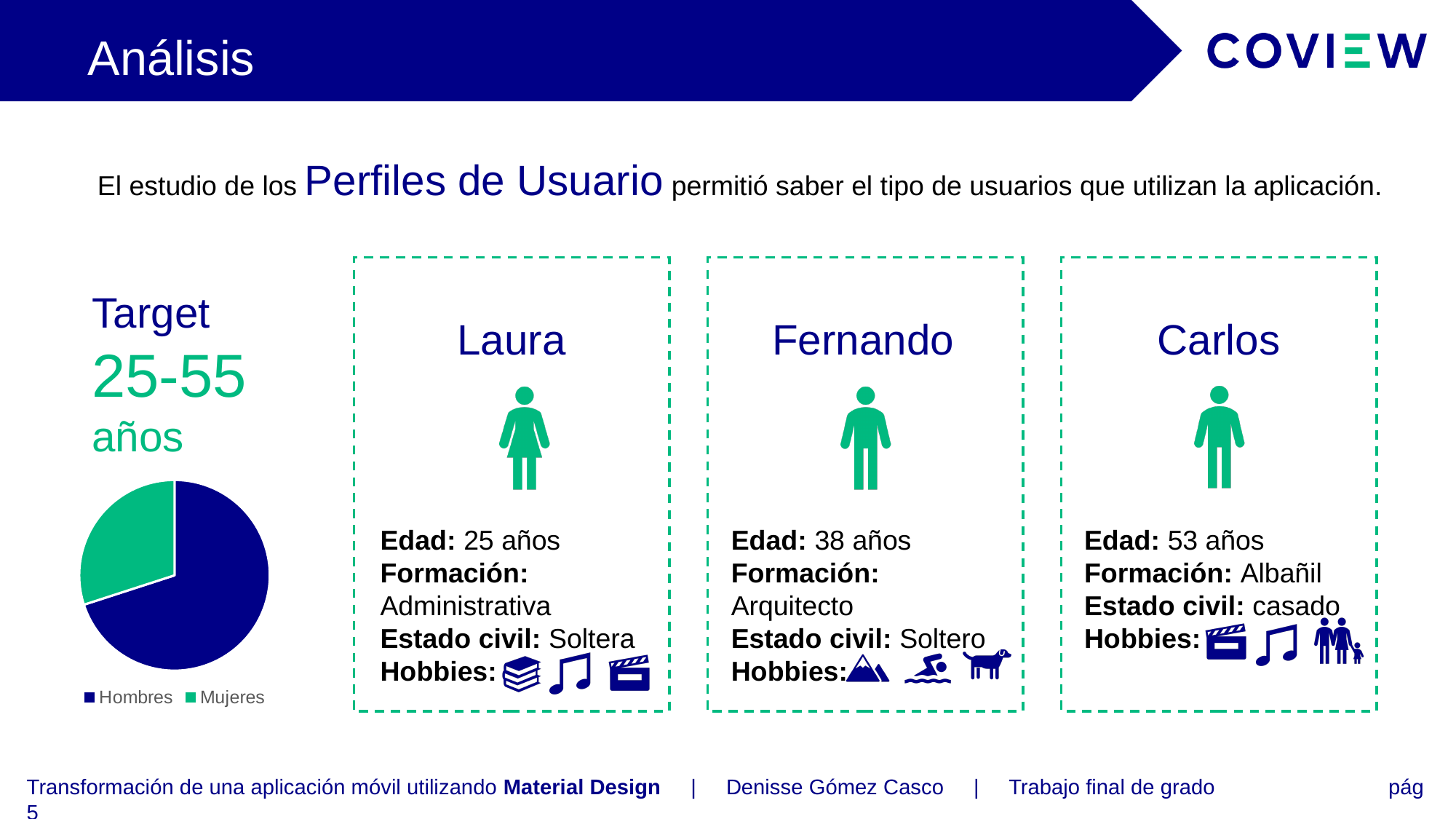
Which category has the largest slice in the pie chart? Hombres What are the two legend entries of the pie chart? Hombres, Mujeres What colour is the Mujeres slice in the pie chart? green What kind of chart is shown on the slide? pie chart How many entries does the legend of the pie chart list? 2 How many slices does the pie chart have? 2 Which category has the smallest slice in the pie chart? Mujeres Which slice is larger in the pie chart, Hombres or Mujeres? Hombres